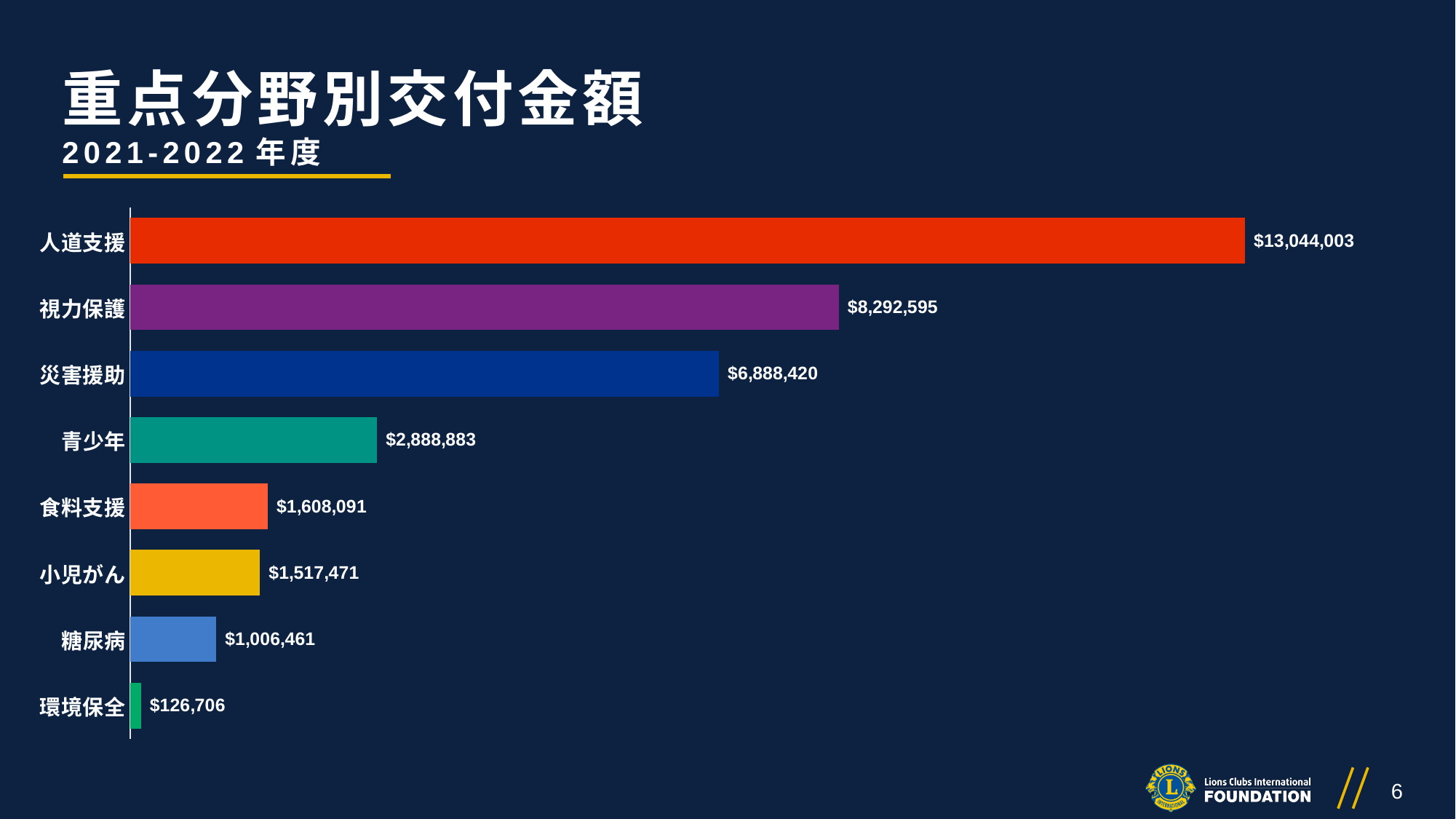
What kind of chart is shown on the slide? Bar chart How many categories are shown in the chart? 8 What is the value for 災害援助? $6,888,420 Which category has the highest value? 人道支援 What is the difference between the values for 食料支援 and 小児がん? $90,620 What is the value for 環境保全? $126,706 What is the value for 糖尿病? $1,006,461 Which category has the lowest value? 環境保全 Which is larger, the value for 青少年 or the value for 食料支援? 青少年 What is the value for 人道支援? $13,044,003 What is the difference between the values for 人道支援 and 視力保護? $4,751,408 What is the title of the slide? 重点分野別交付金額